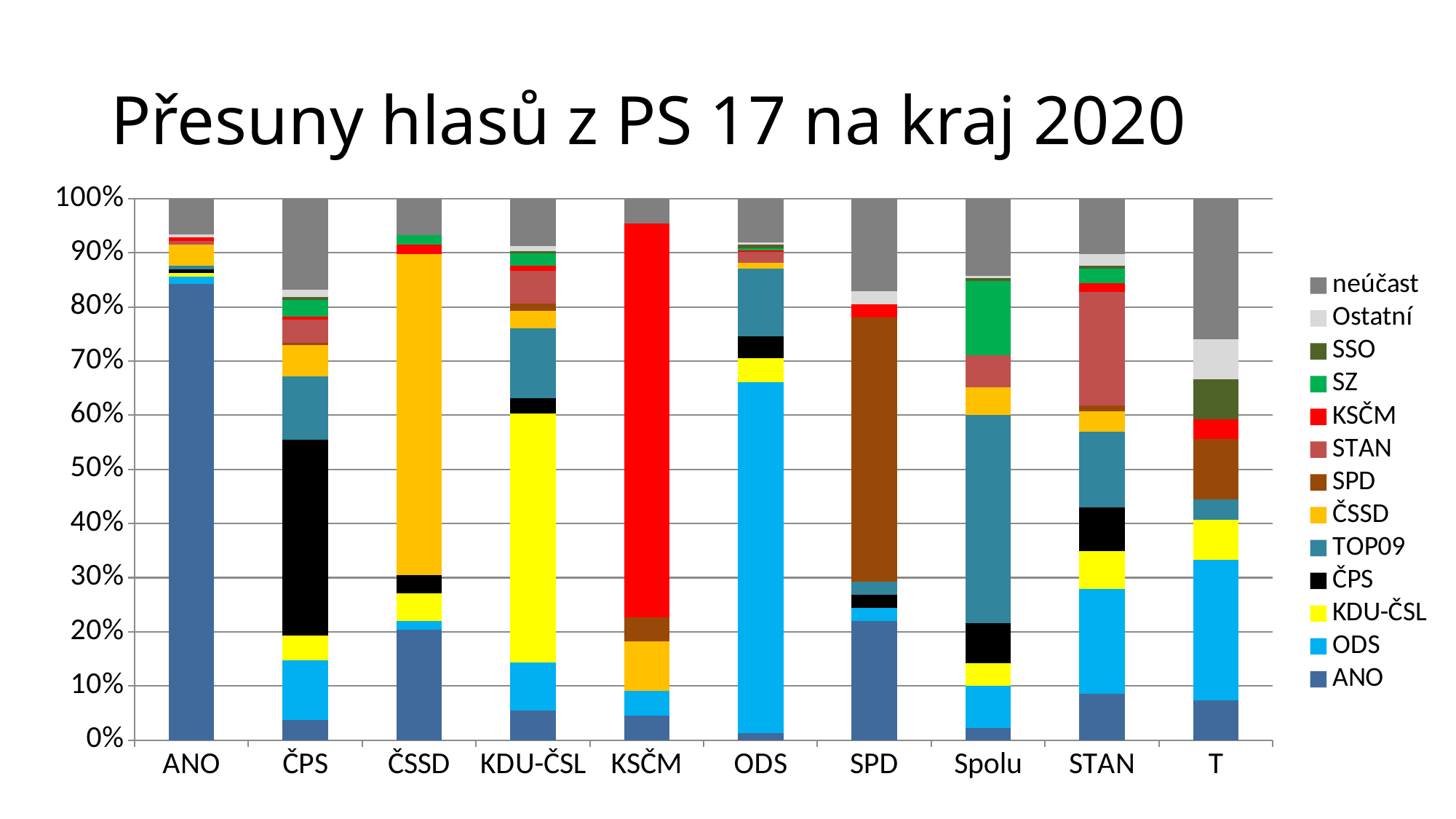
Which is larger: the ANO segment in the ANO bar or the ANO segment in the ČPS bar? the ANO segment in the ANO bar Is the ČSSD segment in the ČSSD bar greater or less than 50%? greater Is the neúčast segment in the KSČM bar greater or less than 10%? less Is the KSČM segment in the KSČM bar greater or less than 70%? greater What is the title of the chart? Přesuny hlasů z PS 17 na kraj 2020 What kind of chart is shown on the slide? stacked bar chart How many categories are shown on the x axis? 10 Which series is listed first (at the top) in the legend? neúčast How many series does the legend list? 13 Which bar has the largest neúčast segment? T